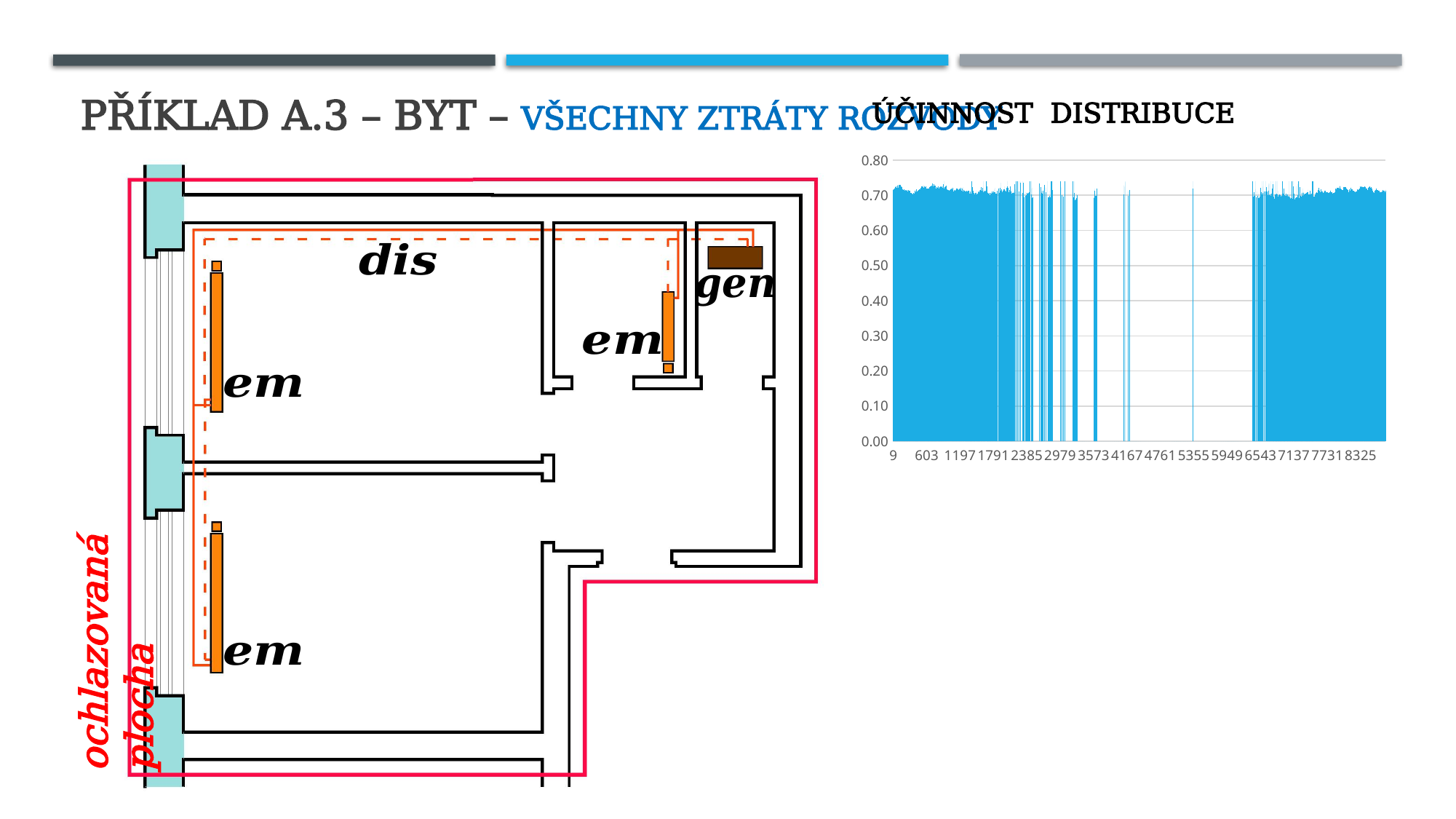
How many tick labels are printed along the horizontal axis of the ÚČINNOST DISTRIBUCE chart? 15 In the ÚČINNOST DISTRIBUCE chart, do the plotted values rise sharply, fall sharply, or stay roughly level between the start of the series and the end of the series? stay roughly level In the ÚČINNOST DISTRIBUCE chart, are the plotted values near the start of the series (around 9 to 1791) greater or less than 0.60? greater In the ÚČINNOST DISTRIBUCE chart, what is the highest value labelled on the vertical axis? 0.80 In the ÚČINNOST DISTRIBUCE chart, are the plotted values near the end of the series (around 7137 to 8325) greater or less than 0.80? less What kind of chart is shown under the title ÚČINNOST DISTRIBUCE? bar chart What is the title of the chart on the right side of the slide? ÚČINNOST DISTRIBUCE In the ÚČINNOST DISTRIBUCE chart, what is the first label on the horizontal axis? 9 In the ÚČINNOST DISTRIBUCE chart, are the plotted values at the beginning of the series greater or less than 0.50? greater What is the step between consecutive labels on the vertical axis of the ÚČINNOST DISTRIBUCE chart? 0.10 In the ÚČINNOST DISTRIBUCE chart, what is the last label on the horizontal axis? 8325